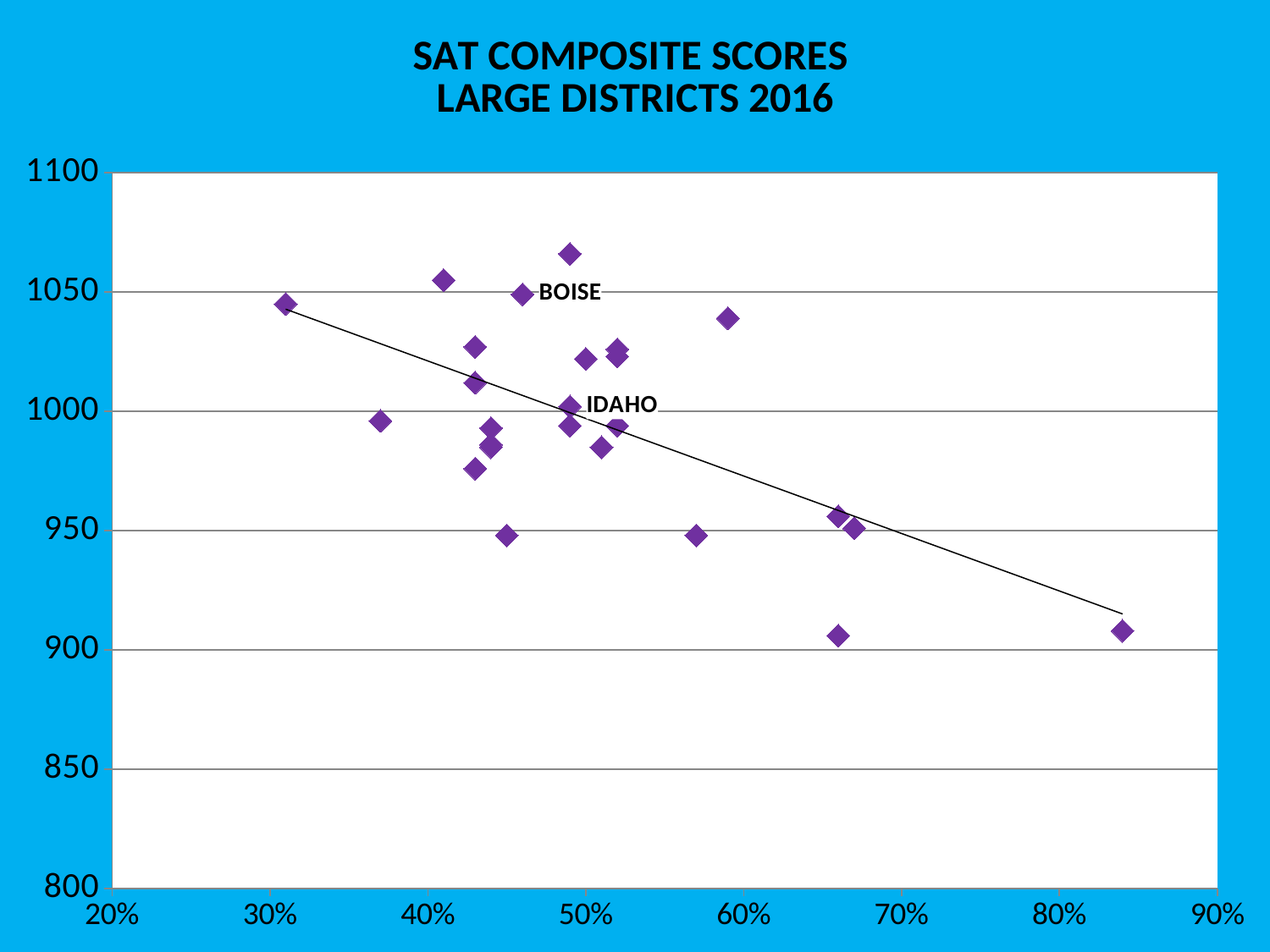
What kind of chart is shown on the slide? Scatter chart Is the SAT composite score for IDAHO greater or less than 950? greater Which labeled point has the higher SAT composite score, BOISE or IDAHO? BOISE Is the SAT composite score for IDAHO greater or less than 1050? less Is the SAT composite score for BOISE greater or less than 1000? greater Which two points on the chart are labeled by name? BOISE and IDAHO What is the title of the chart? SAT COMPOSITE SCORES LARGE DISTRICTS 2016 Do the SAT composite scores generally rise or fall as the percentage on the x axis increases? Fall